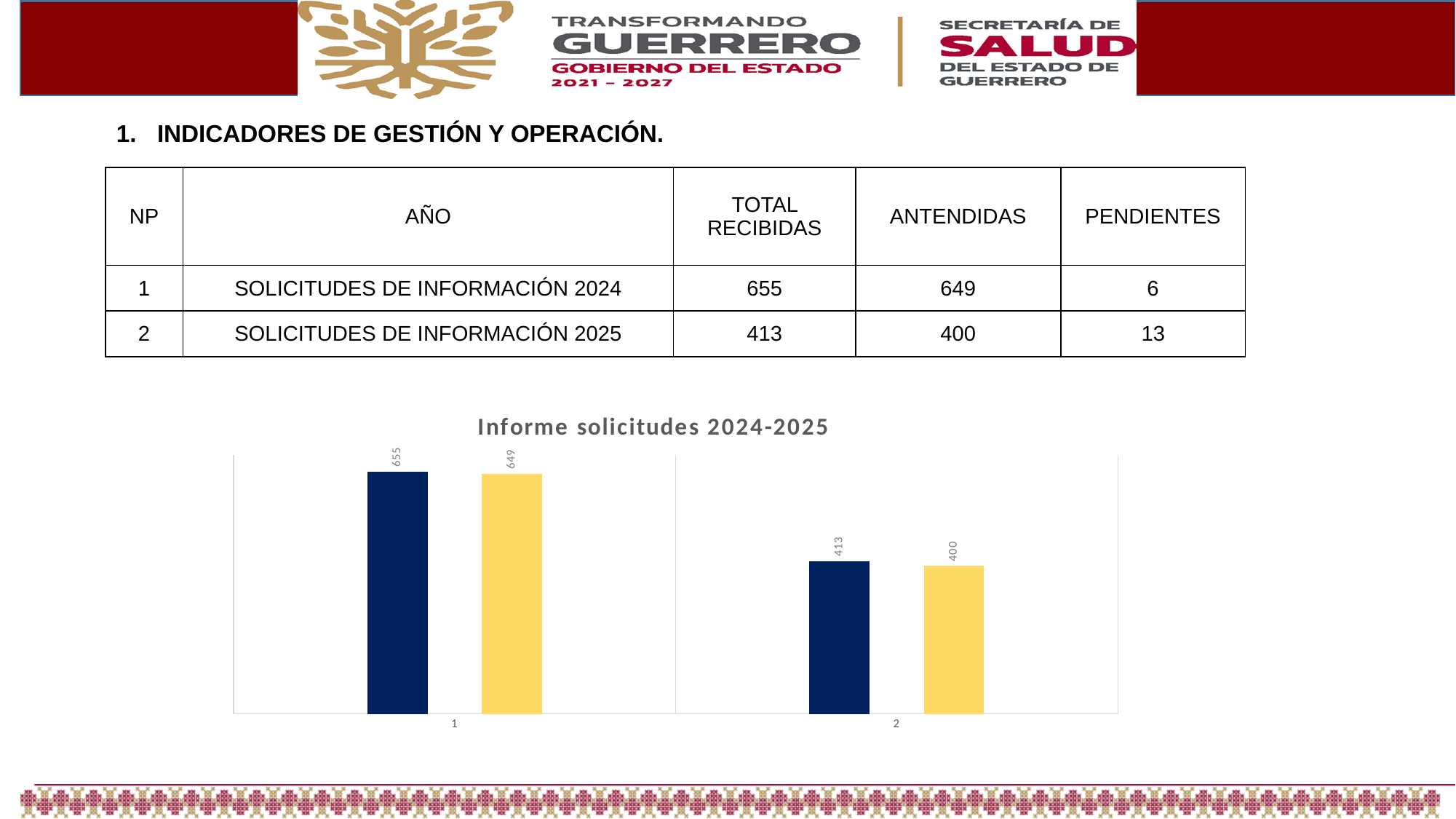
In the chart, what is the value of the yellow bar for category 1? 649 What is the title of the chart? Informe solicitudes 2024-2025 In the chart, what is the value of the dark blue bar for category 1? 655 In the chart, what is the difference between the dark blue bar for category 1 and the dark blue bar for category 2? 242 In the chart, what is the value of the dark blue bar for category 2? 413 In the chart, what is the value of the yellow bar for category 2? 400 What kind of chart is shown under the title "Informe solicitudes 2024-2025"? bar chart In the chart, what is the difference between the dark blue bar and the yellow bar for category 2? 13 In the chart, which is larger: the yellow bar for category 1 or the dark blue bar for category 2? the yellow bar for category 1 In the chart, which bar has the highest value? the dark blue bar for category 1 (655) In the chart, which bar has the lowest value? the yellow bar for category 2 (400) How many categories are shown on the x axis of the chart? 2